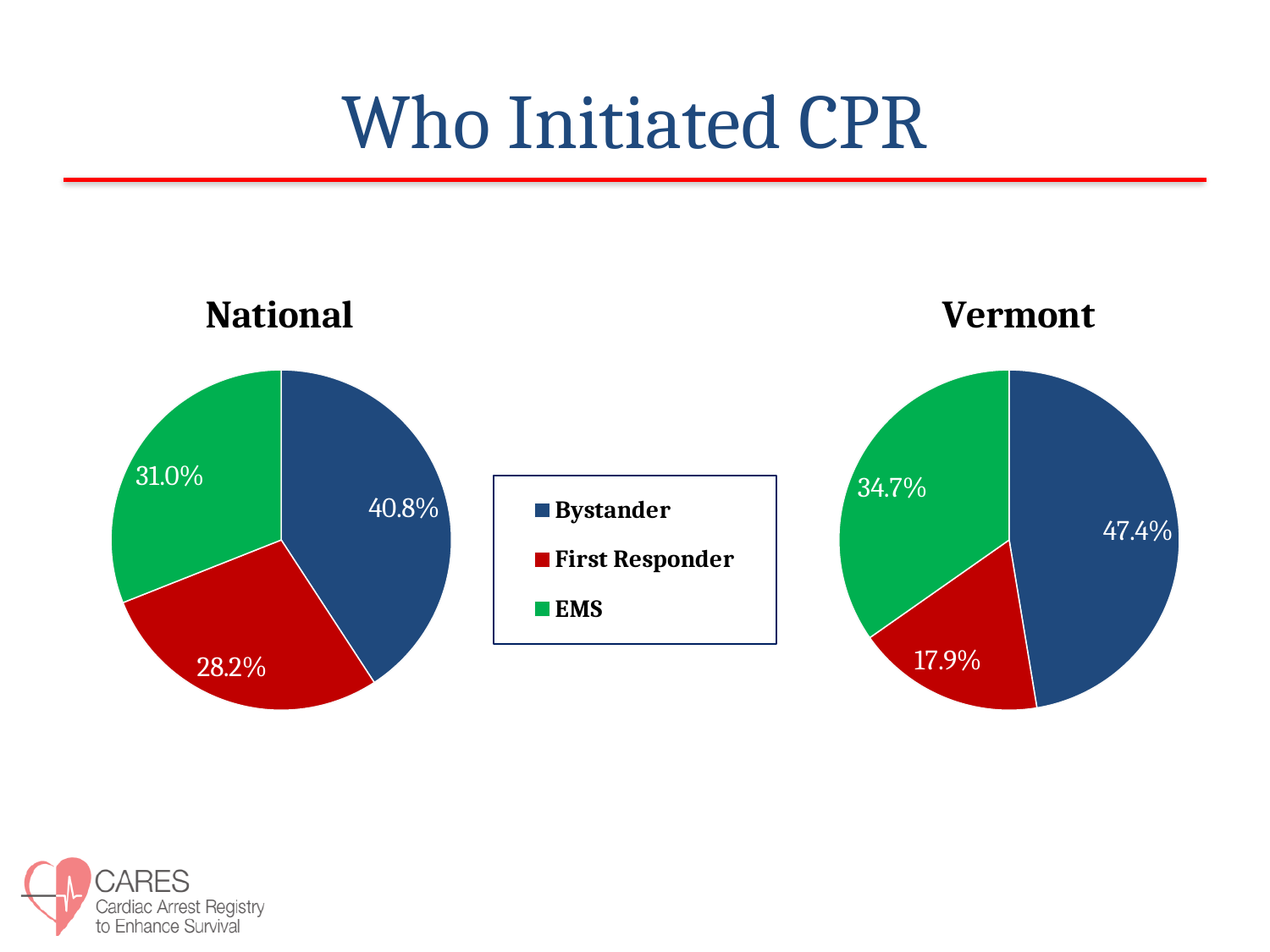
Which is larger: the First Responder share in the National chart or the First Responder share in the Vermont chart? National What is the difference between the Bystander share in the Vermont chart and the Bystander share in the National chart? 6.6% How many categories does the legend list for the pie charts? 3 In the Vermont pie chart, what share of CPR was initiated by First Responders? 17.9% In the Vermont pie chart, what is the difference between the EMS share and the First Responder share? 16.8% In the Vermont pie chart, what share of CPR was initiated by EMS? 34.7% In the National pie chart, which category has the largest share? Bystander In the National pie chart, what share of CPR was initiated by Bystanders? 40.8% In the National pie chart, which category has the smallest share? First Responder In the National pie chart, what share of CPR was initiated by EMS? 31.0% In the Vermont pie chart, which category has the smallest share? First Responder What type of chart is used for the National and Vermont data? Pie chart